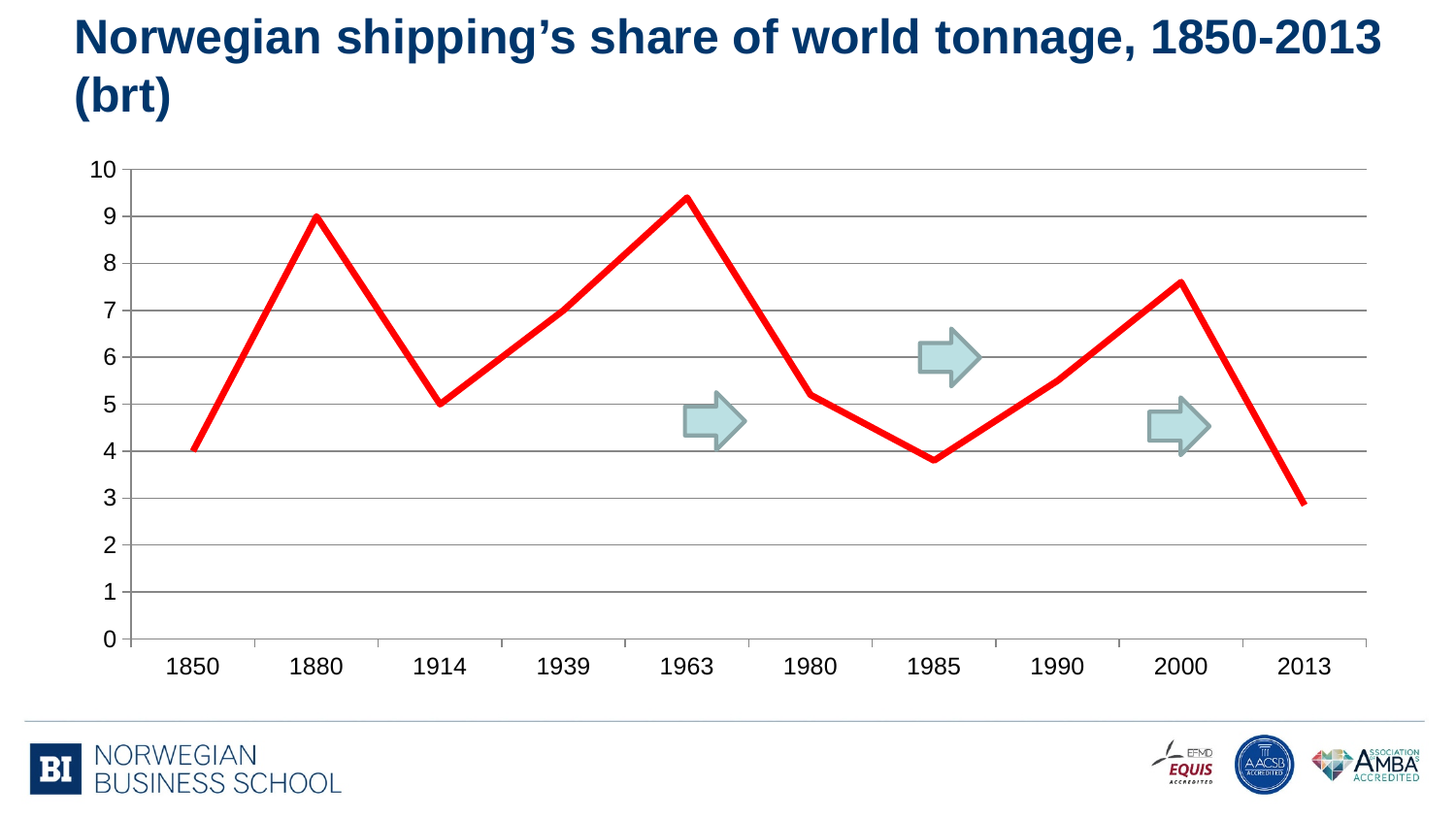
Does the line rise or fall between 2000 and 2013? fall What is the value for 1914? 5 By how much does the value for 1880 exceed the value for 1850? 5 What is the value for 1880? 9 Which is larger, the value for 1880 or the value for 1914? 1880 How many years are plotted along the x axis? 10 In which year is Norwegian shipping's share of world tonnage lowest? 2013 What is the value for 1850? 4 In which year is Norwegian shipping's share of world tonnage highest? 1963 Is the value for 1963 greater or less than 9? greater Is the value for 1985 greater or less than 4? less What kind of chart is shown on the slide? line chart